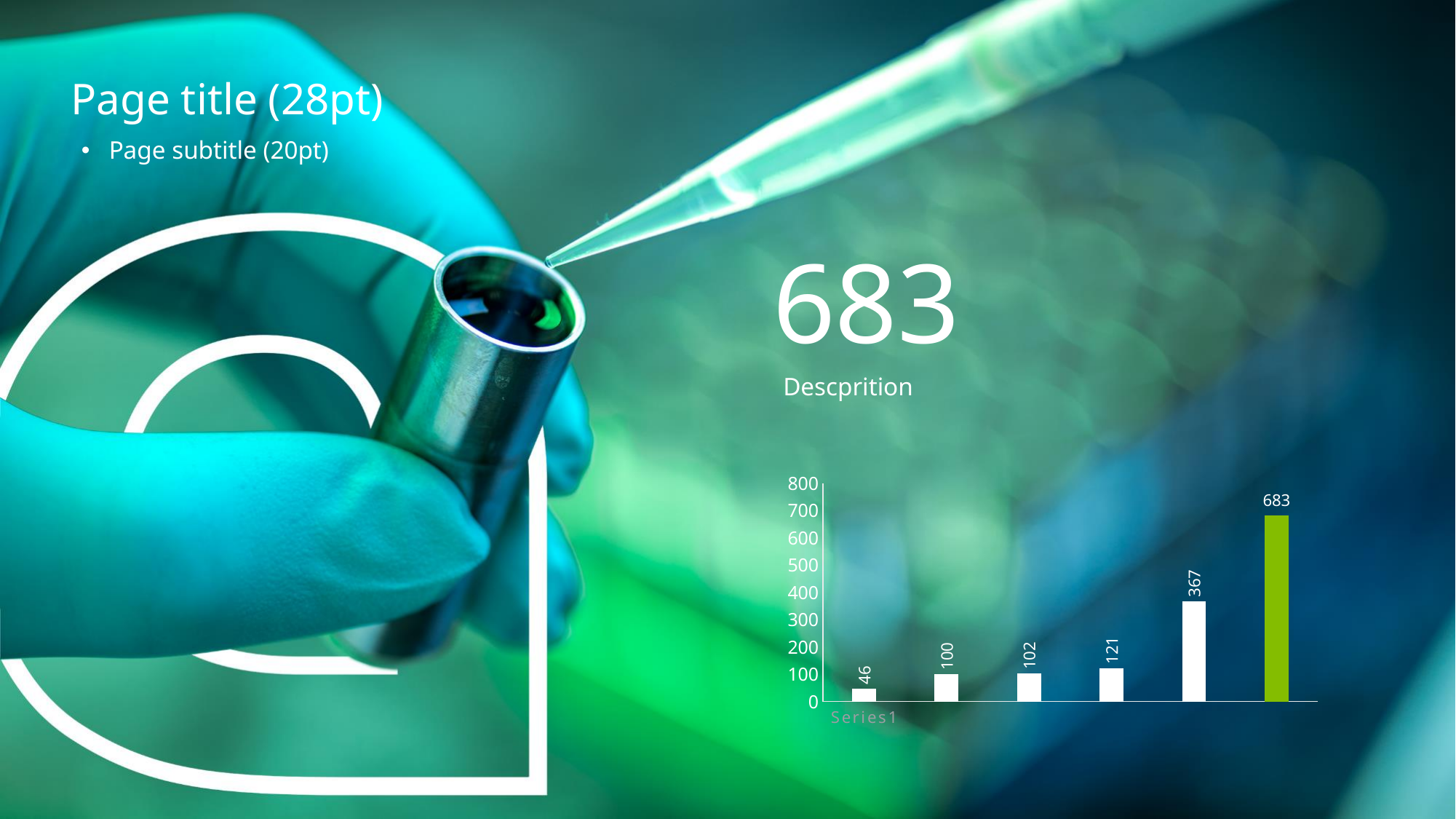
How many bars are plotted in the chart? 6 Which bar has the lowest value in the chart? the first (leftmost) bar, 46 What is the value of the fifth bar in the chart? 367 Which is larger, the value of the second bar or the value of the fourth bar? the fourth bar (121) Which bar has the highest value in the chart? the last (rightmost) bar, 683 What is the value of the first (leftmost) bar in the chart? 46 What is the difference between the values of the last bar and the fifth bar? 316 What is the value of the fourth bar in the chart? 121 Do the bar values rise or fall from left to right across the chart? rise What type of chart is shown on the slide? bar chart What colour is the tallest bar in the chart? green What is the value of the last (rightmost) bar in the chart? 683